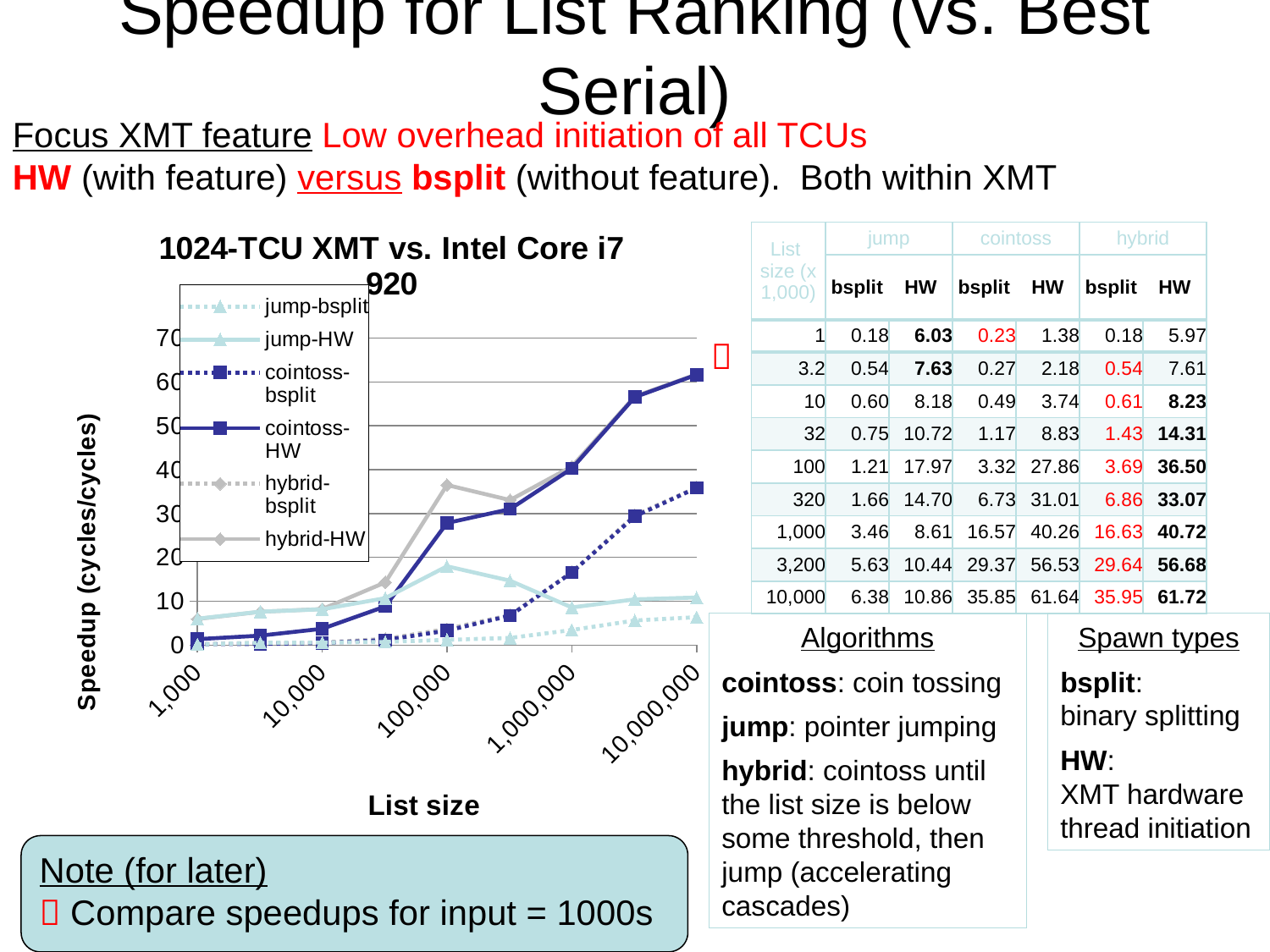
At list size 10,000,000, which is larger: cointoss-HW or cointoss-bsplit? cointoss-HW What is the label of the chart's y axis? Speedup (cycles/cycles) Is the value of the jump-bsplit series at list size 10,000,000 greater or less than 10? less What is the title of the chart? 1024-TCU XMT vs. Intel Core i7 920 Is the value of the cointoss-HW series at list size 10,000,000 greater or less than 50? greater What kind of chart is shown on the slide? line chart Is the value of the hybrid-HW series at list size 100,000 greater or less than 30? greater How many labelled tick marks are on the chart's x axis (List size)? 5 How many series does the chart legend list? 6 At list size 100,000, which is larger: hybrid-HW or cointoss-HW? hybrid-HW Which series has the lowest value at list size 10,000,000? jump-bsplit Does the cointoss-HW series generally rise or fall as list size increases along the x axis? rise